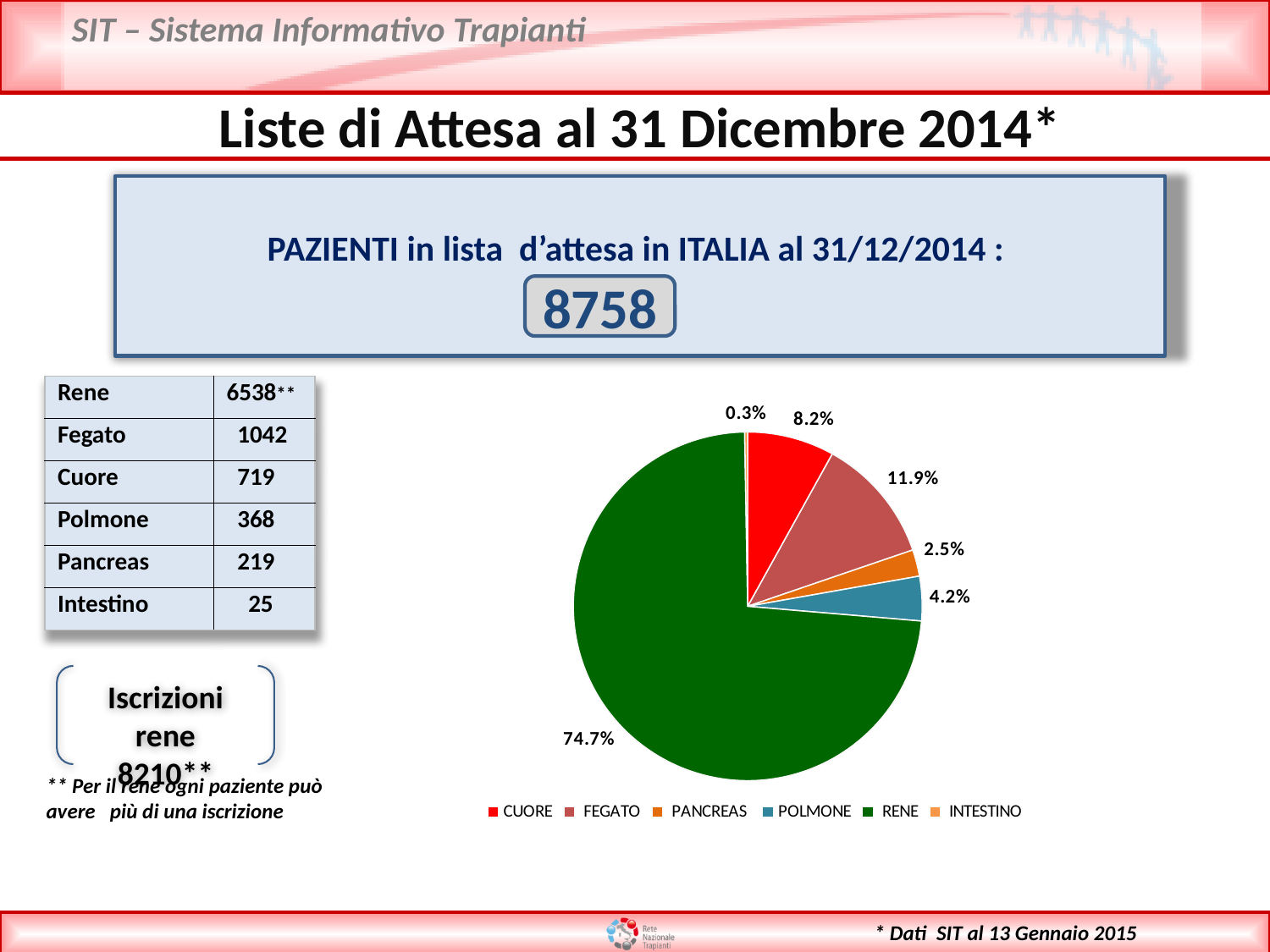
Which category has the smallest slice in the pie chart? INTESTINO What share of the pie chart does PANCREAS represent? 2.5% What is the difference in percentage points between the FEGATO and POLMONE slices? 7.7 What share of the pie chart does RENE represent? 74.7% What share of the pie chart does INTESTINO represent? 0.3% What type of chart is shown on the slide? pie chart Which slice is larger in the pie chart, FEGATO or CUORE? FEGATO How many categories does the pie chart legend list? 6 Which category has the largest slice in the pie chart? RENE